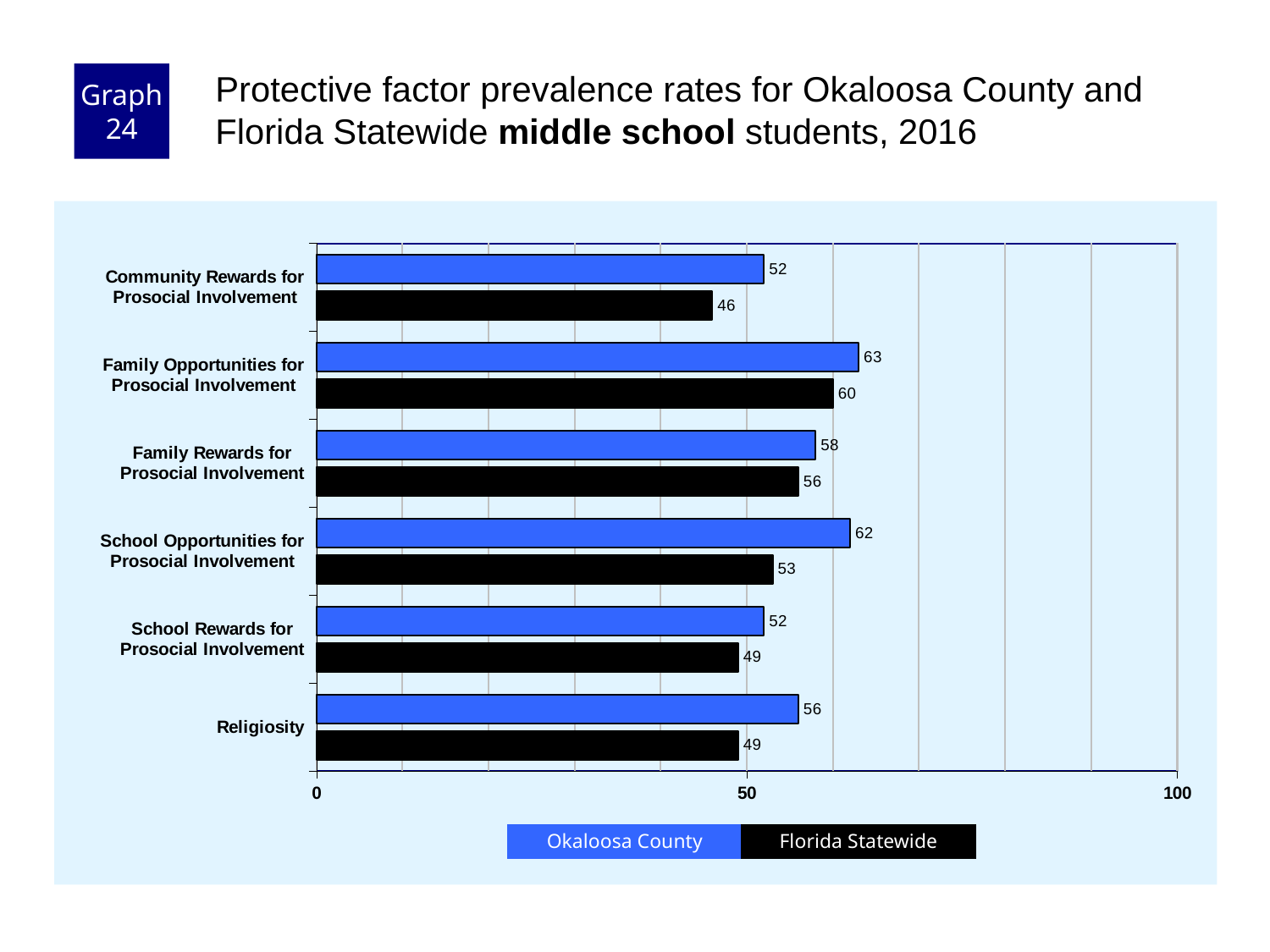
How many categories are shown on the chart? 6 What is the difference between the Okaloosa County and Florida Statewide values for School Opportunities for Prosocial Involvement? 9 What kind of chart is shown on the slide? bar chart Which category has the lowest Florida Statewide value? Community Rewards for Prosocial Involvement Which colour represents Florida Statewide in the chart? black What is the Florida Statewide value for Religiosity? 49 Is the Florida Statewide value for School Rewards for Prosocial Involvement greater or less than 50? less How many series does the legend list? 2 What is the Okaloosa County value for Family Opportunities for Prosocial Involvement? 63 Which category has the highest Okaloosa County value? Family Opportunities for Prosocial Involvement What is the Florida Statewide value for Community Rewards for Prosocial Involvement? 46 Which is larger for Religiosity: the Okaloosa County value or the Florida Statewide value? Okaloosa County